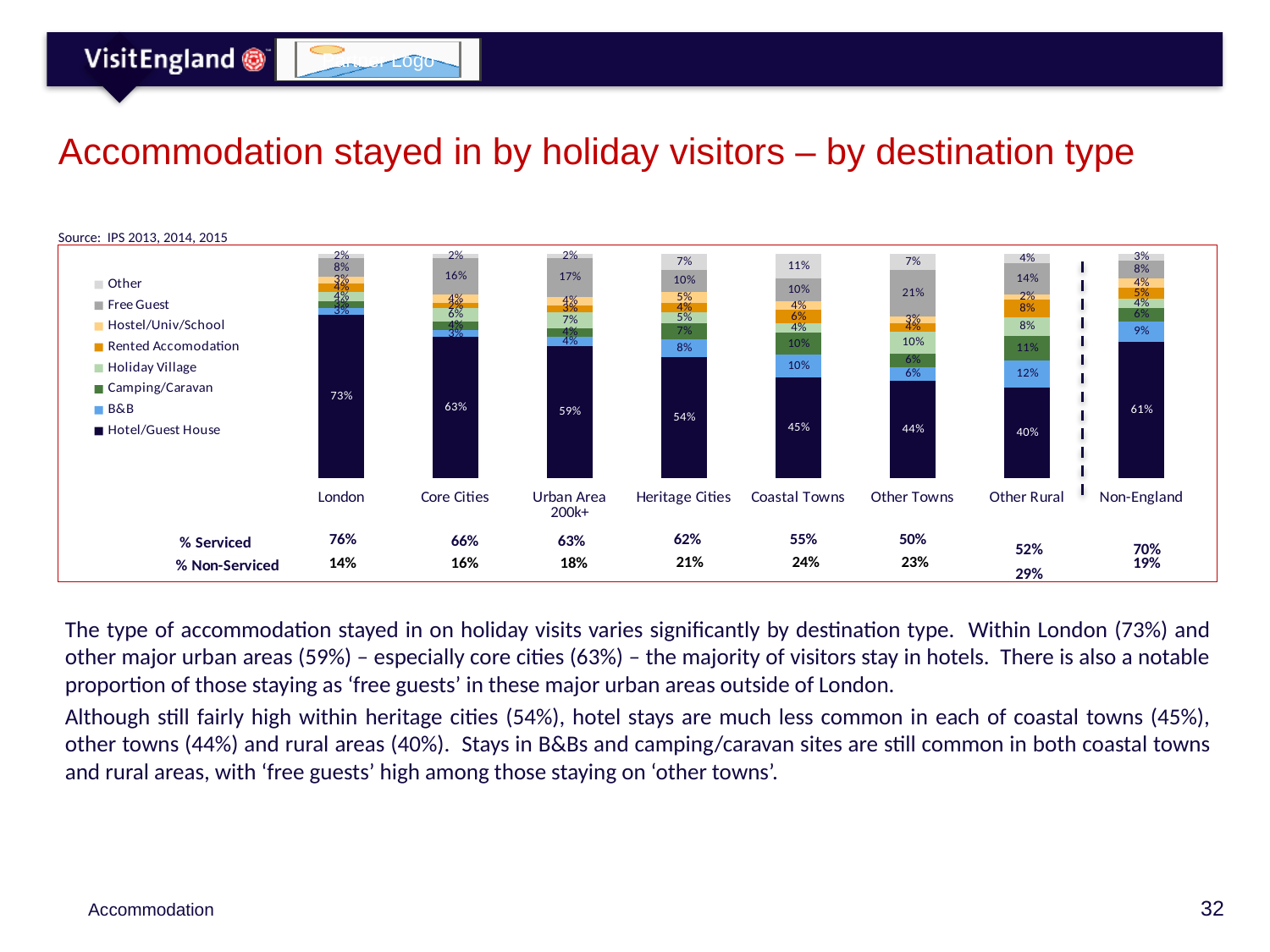
What is the Hotel/Guest House share for London? 73% Which series is shown at the bottom of each stacked bar? Hotel/Guest House What is the difference between the Hotel/Guest House share for London and for Other Rural? 33% Which destination type has the highest Hotel/Guest House share? London What is the Camping/Caravan share for Other Rural? 11% Which destination type has the lowest Hotel/Guest House share? Other Rural Which is larger, the B&B share for Other Rural or for Other Towns? Other Rural What type of chart is shown on the slide? stacked bar chart What is the Other share for Coastal Towns? 11% What is the Free Guest share for Other Towns? 21% How many destination types are shown along the x axis? 8 How many series does the legend list? 8